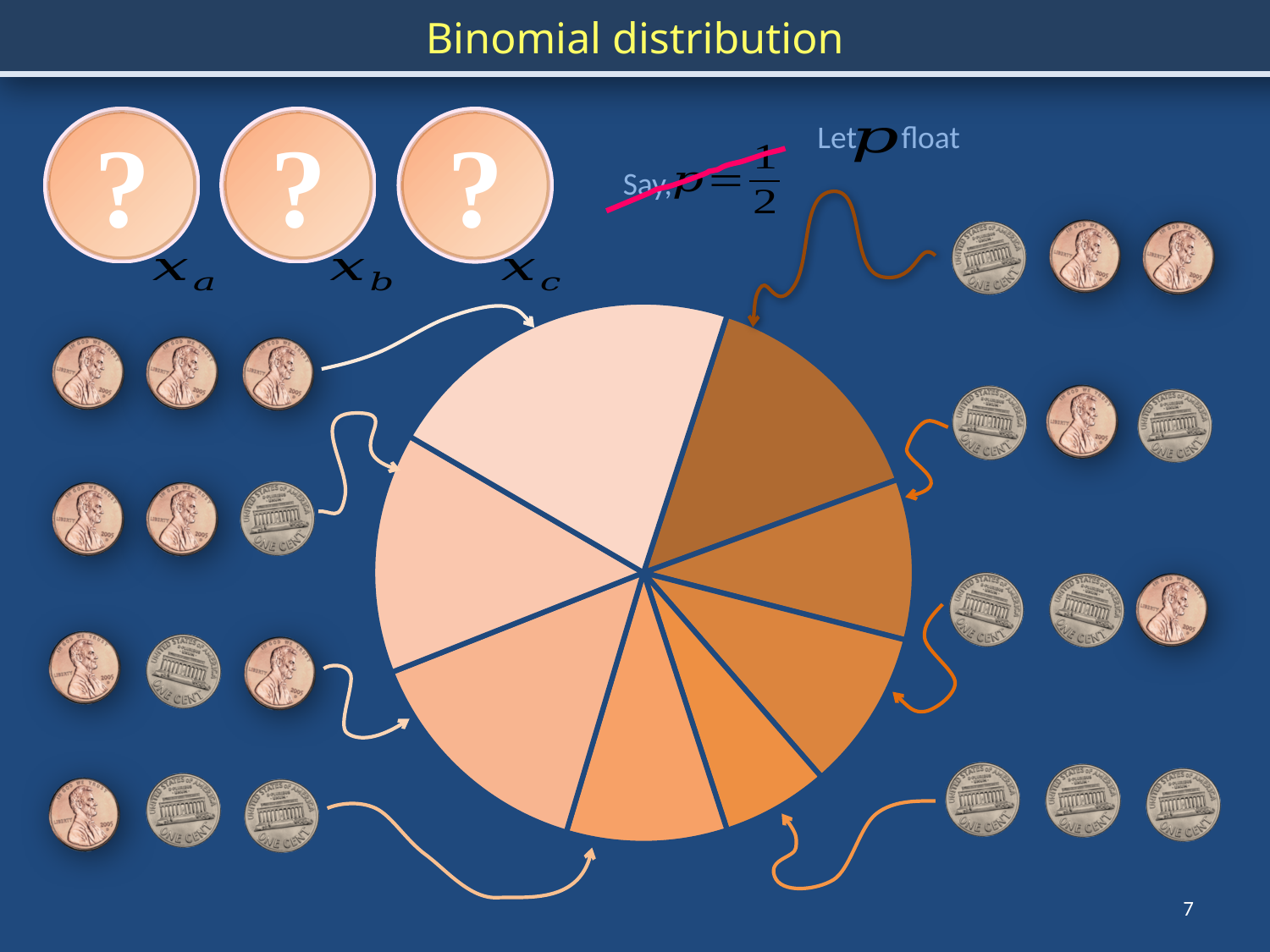
Are all the slices of the pie chart the same size? no What kind of chart is shown on the slide? pie chart Does the pie chart display a legend? no How many slices does the pie chart have? 8 What is the title of the slide containing the pie chart? Binomial distribution